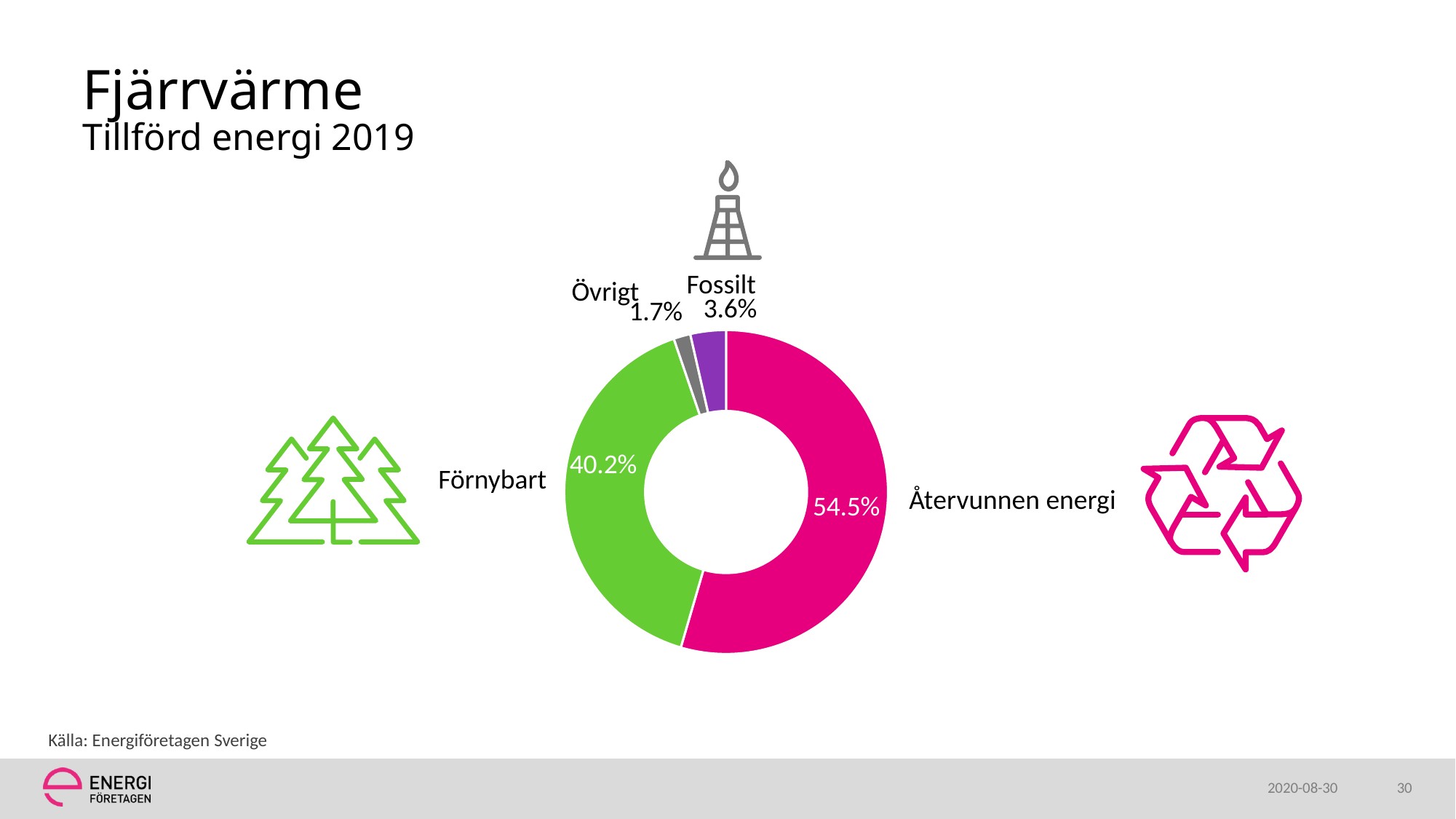
What share of the chart does Återvunnen energi account for? 54.5% What is the subtitle of the slide above the chart? Tillförd energi 2019 What colour is the Förnybart slice? Green What is the value shown for Förnybart? 40.2% What is the value shown for Fossilt? 3.6% What kind of chart is shown on the slide? Pie chart (doughnut) Which is larger, Fossilt or Övrigt? Fossilt Which category has the largest share? Återvunnen energi How many categories are shown in the chart? 4 Which category has the smallest share? Övrigt What is the value shown for Övrigt? 1.7% What is the difference in percentage points between Återvunnen energi and Förnybart? 14.3